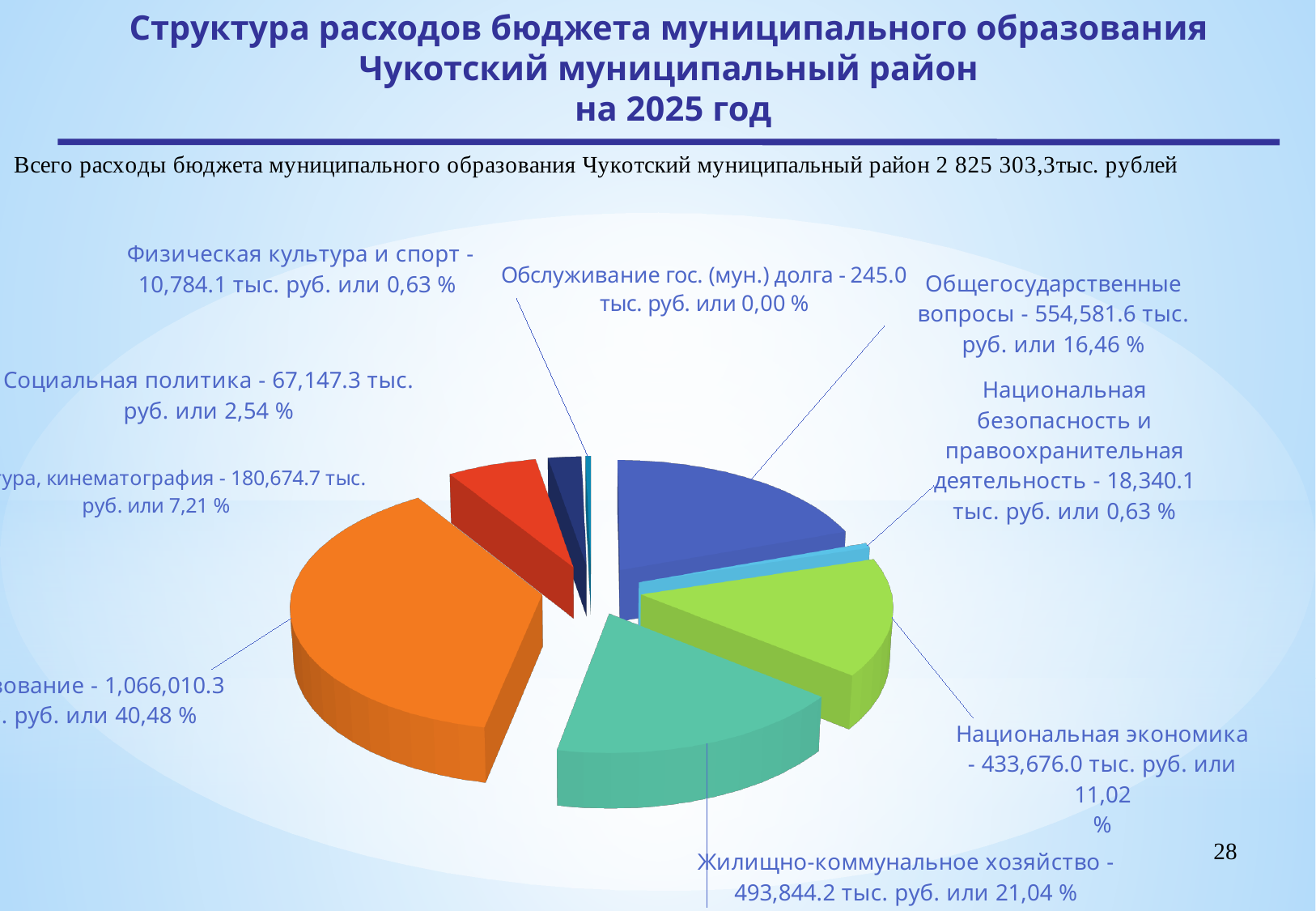
What kind of chart is shown on the slide? Pie chart What share of the budget expenditure goes to Жилищно-коммунальное хозяйство? 21,04 % What percentage share is shown for Социальная политика? 2,54 % Which is larger: Общегосударственные вопросы or Национальная экономика? Общегосударственные вопросы What total budget expenditure is stated on the slide? 2 825 303,3 тыс. рублей Which category has the smallest share of expenditure? Обслуживание гос. (мун.) долга What percentage share is shown for Национальная безопасность и правоохранительная деятельность? 0,63 % What is the value for Физическая культура и спорт? 10,784.1 тыс. руб. How many categories are shown in the pie chart? 9 What is the value for Общегосударственные вопросы? 554,581.6 тыс. руб. What is the value for Национальная экономика? 433,676.0 тыс. руб. What is the difference in value between Жилищно-коммунальное хозяйство and Национальная экономика? 60,168.2 тыс. руб.